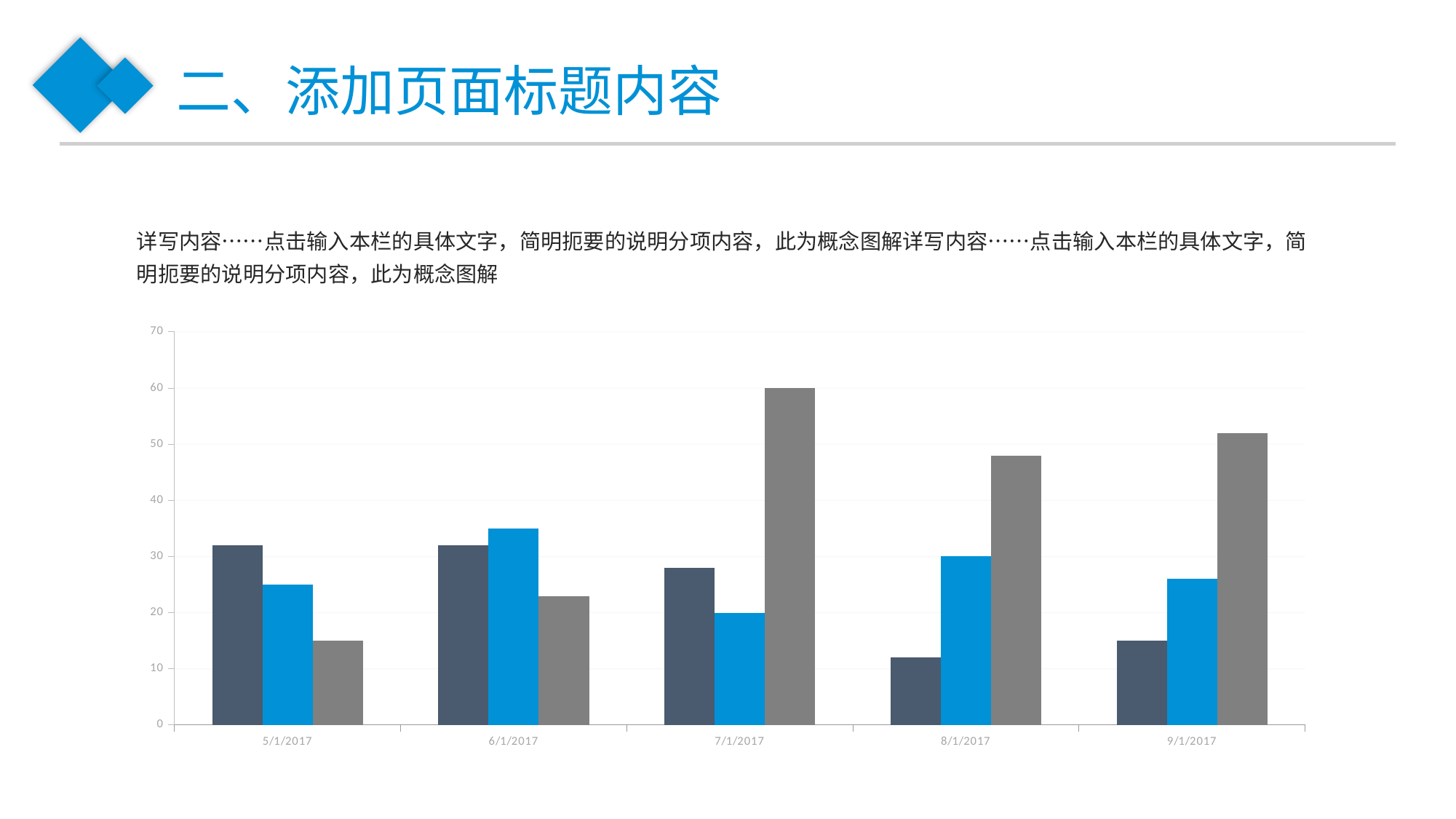
What kind of chart is shown on the slide? bar chart What is the value of the light blue bar for 8/1/2017? 30 Is the value of the grey bar for 9/1/2017 greater or less than 50? greater Among the grey bars, which date category has the lowest value? 5/1/2017 What is the value of the grey bar for 7/1/2017? 60 Which date category has the tallest bar in the chart? 7/1/2017 For 5/1/2017, which is larger: the dark blue bar or the grey bar? the dark blue bar Among the dark blue bars, which date category has the lowest value? 8/1/2017 How many bars are shown for each date category in the chart? 3 Is the value of the dark blue bar for 5/1/2017 greater or less than 30? greater What is the value of the light blue bar for 7/1/2017? 20 How many categories are shown on the x axis of the chart? 5